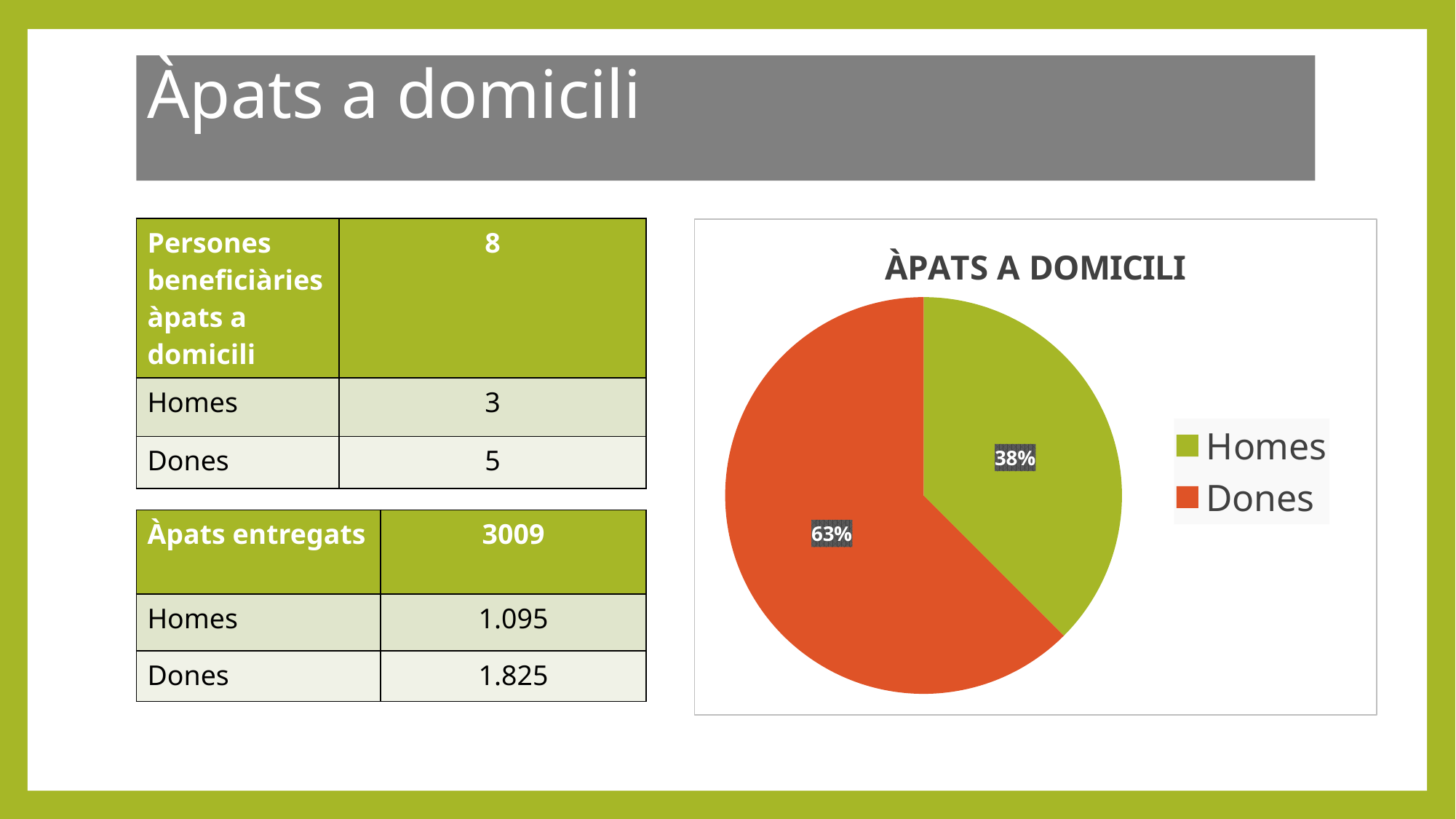
What type of chart is shown on the slide? pie chart What colour is the Homes slice in the pie chart? green How many slices does the pie chart have? 2 What is the difference in percentage points between the Dones slice and the Homes slice? 25 How many entries does the legend list? 2 Which category has the smallest slice in the pie chart? Homes What percentage is shown for Homes in the pie chart? 38% What is the title of the chart? ÀPATS A DOMICILI Which slice is larger, Homes or Dones? Dones What percentage is shown for Dones in the pie chart? 63% Is the share for Homes greater or less than 50%? less Which category has the largest slice in the pie chart? Dones